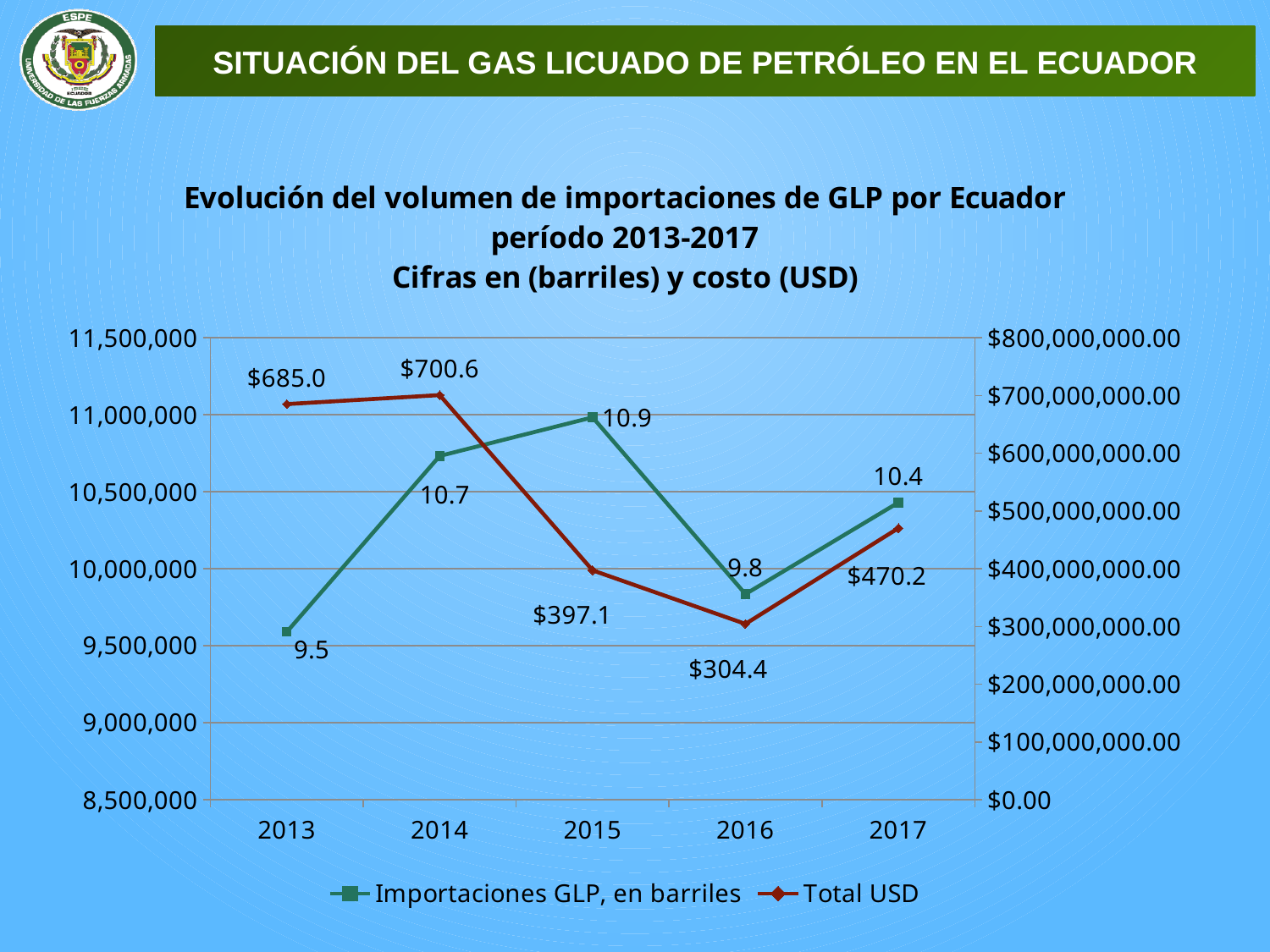
What is the difference between the Total USD values for 2014 and 2016? $396.2 Is the Importaciones GLP, en barriles value for 2013 greater or less than 10,000,000 on the left axis? less How many series does the legend list? 2 How many years are plotted on the x axis? 5 In which year is the Importaciones GLP, en barriles series lowest? 2013 What is the Total USD value shown for 2016? $304.4 What is the difference between the Importaciones GLP labels for 2015 and 2013? 1.4 What kind of chart is shown on the slide? line chart What is the Total USD value shown for 2014? $700.6 Which year has a larger Total USD value, 2013 or 2017? 2013 In which year is the Total USD series highest? 2014 What is the data label for Importaciones GLP, en barriles in 2015? 10.9